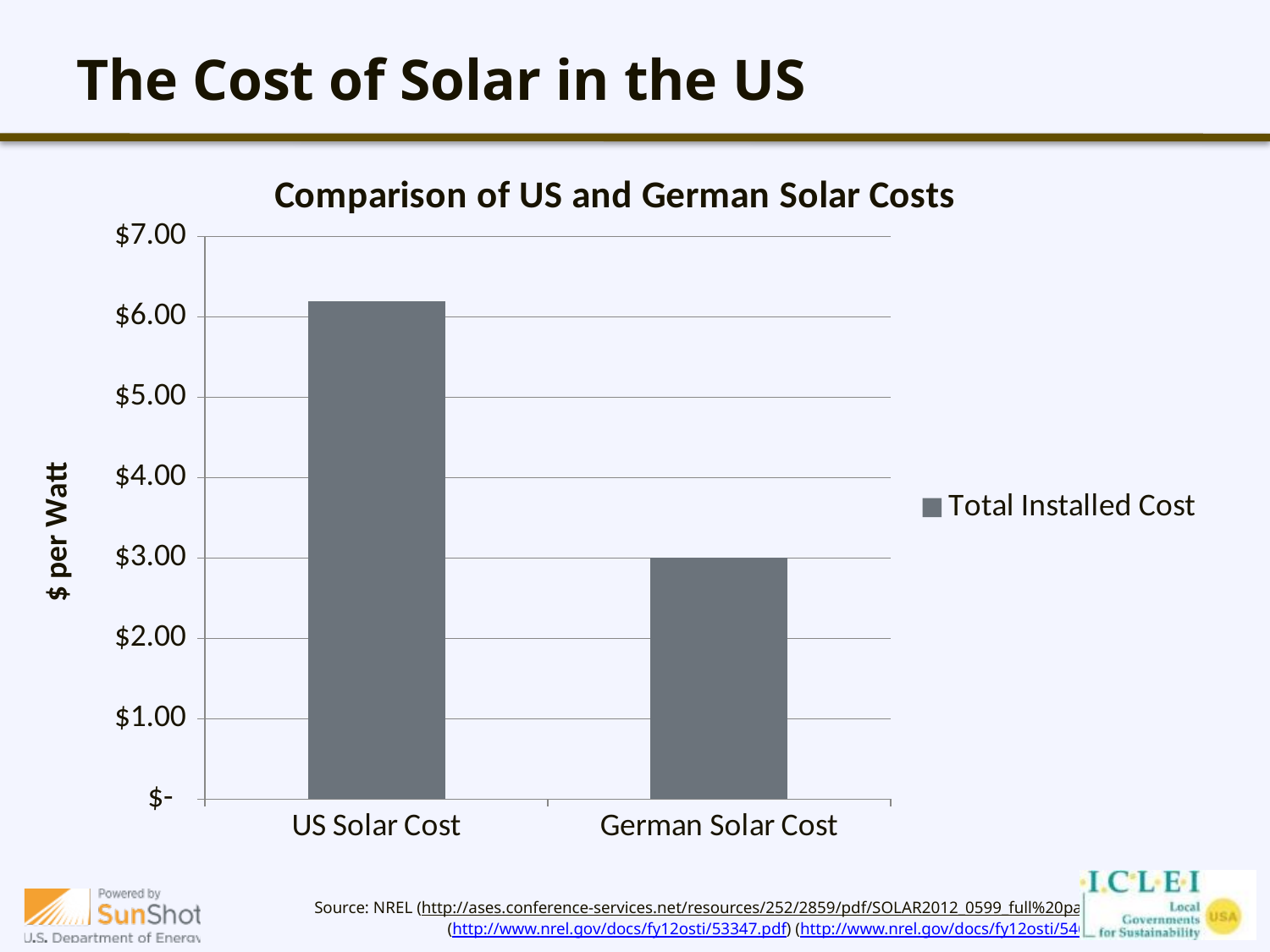
Which category has the highest Total Installed Cost? US Solar Cost Is the value for German Solar Cost greater or less than $4.00? less How many categories are plotted in the chart? 2 What is the title of the chart? Comparison of US and German Solar Costs Is the value for US Solar Cost greater or less than $6.00? greater What kind of chart is shown on the slide? bar chart What is the label on the vertical axis of the chart? $ per Watt Which is larger, the Total Installed Cost for US Solar Cost or for German Solar Cost? US Solar Cost How many series does the legend list? 1 Which category has the lowest Total Installed Cost? German Solar Cost Is the value for US Solar Cost greater or less than $7.00? less